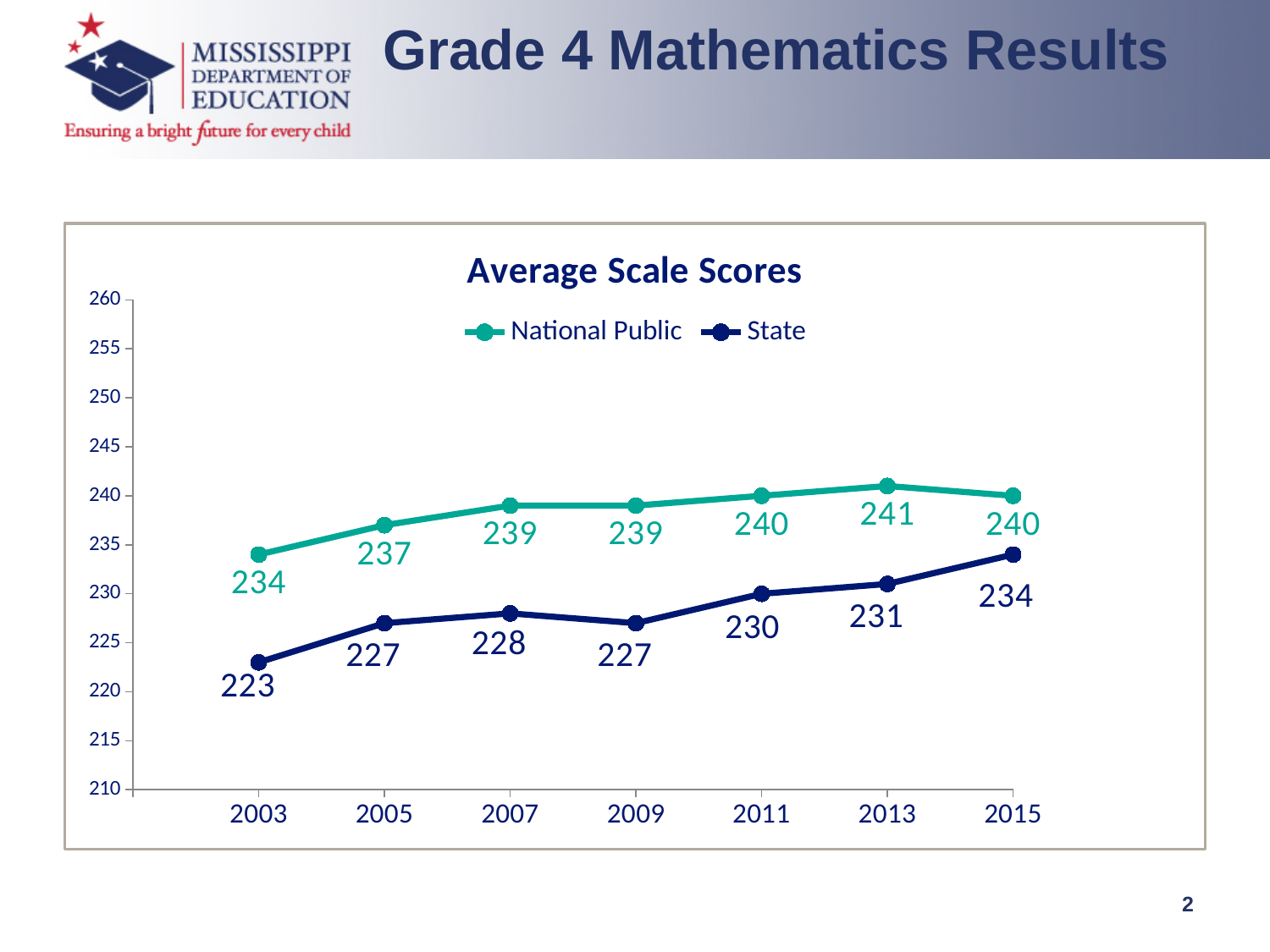
What is the title of the chart? Average Scale Scores What was the State average scale score in 2003? 223 What is the difference between the National Public and State scores in 2015? 6 In which year was the State average scale score lowest? 2003 What kind of chart is shown on the slide? Line chart Which series had the higher score in 2009, National Public or State? National Public In which year was the National Public average scale score highest? 2013 How many series does the legend list? 2 How many years are plotted on the x axis? 7 What was the National Public average scale score in 2013? 241 By how much did the State score increase from 2003 to 2015? 11 What was the State average scale score in 2015? 234